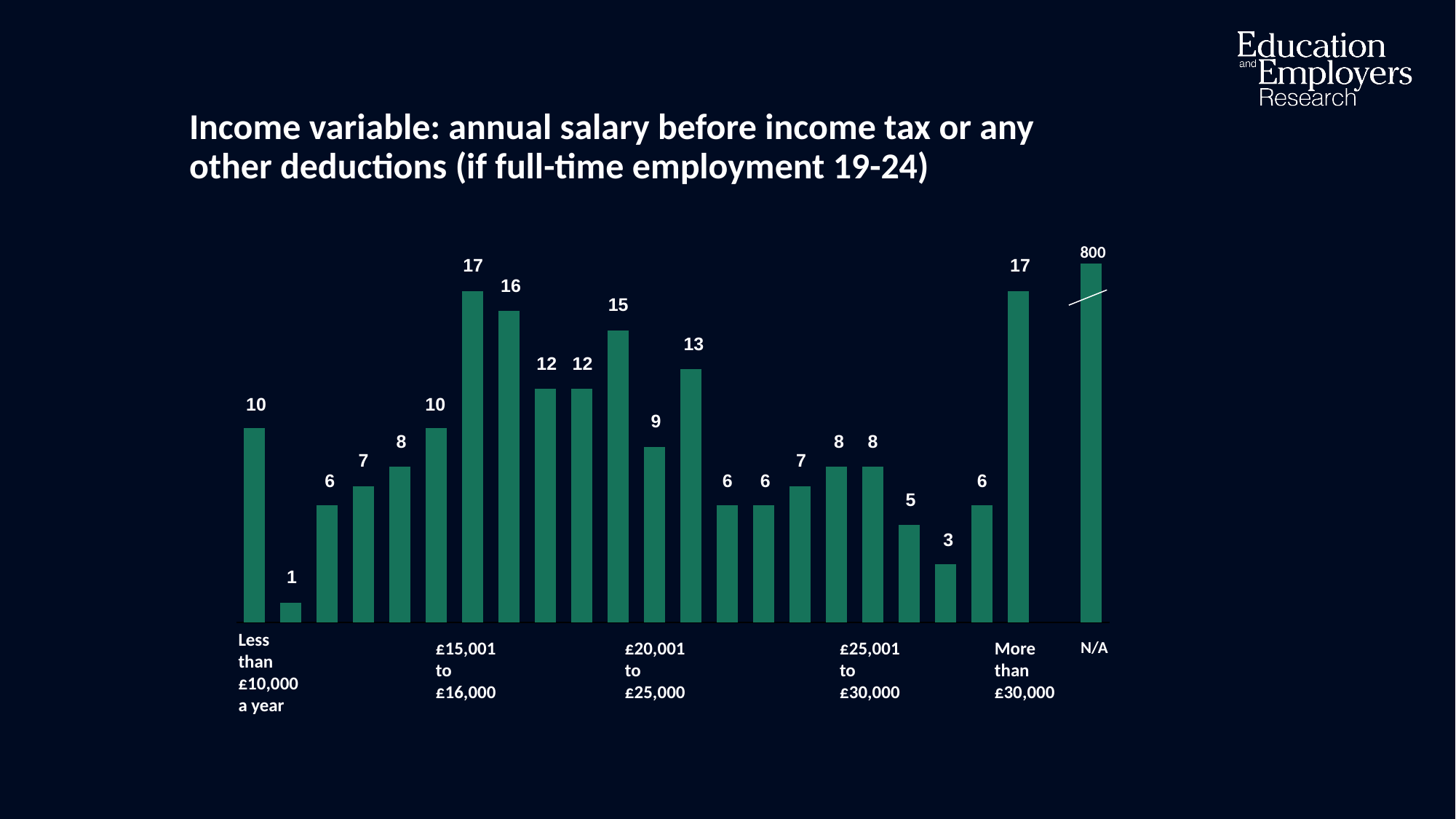
What colour are the bars in the chart? Green Which is larger, the value for 'More than £30,000' or the value for 'Less than £10,000 a year'? More than £30,000 What is the value for the '£15,001 to £16,000' category? 10 What is the value for the 'Less than £10,000 a year' category? 10 What is the value for the '£20,001 to £25,000' category? 15 What is the value for the 'More than £30,000' category? 17 What kind of chart is shown on the slide? Bar chart What is the difference between the value for 'More than £30,000' and the value for '£25,001 to £30,000'? 9 How many bars are plotted in the chart? 23 What is the value for the N/A category? 800 What is the value for the '£25,001 to £30,000' category? 8 Which category has the highest value? N/A